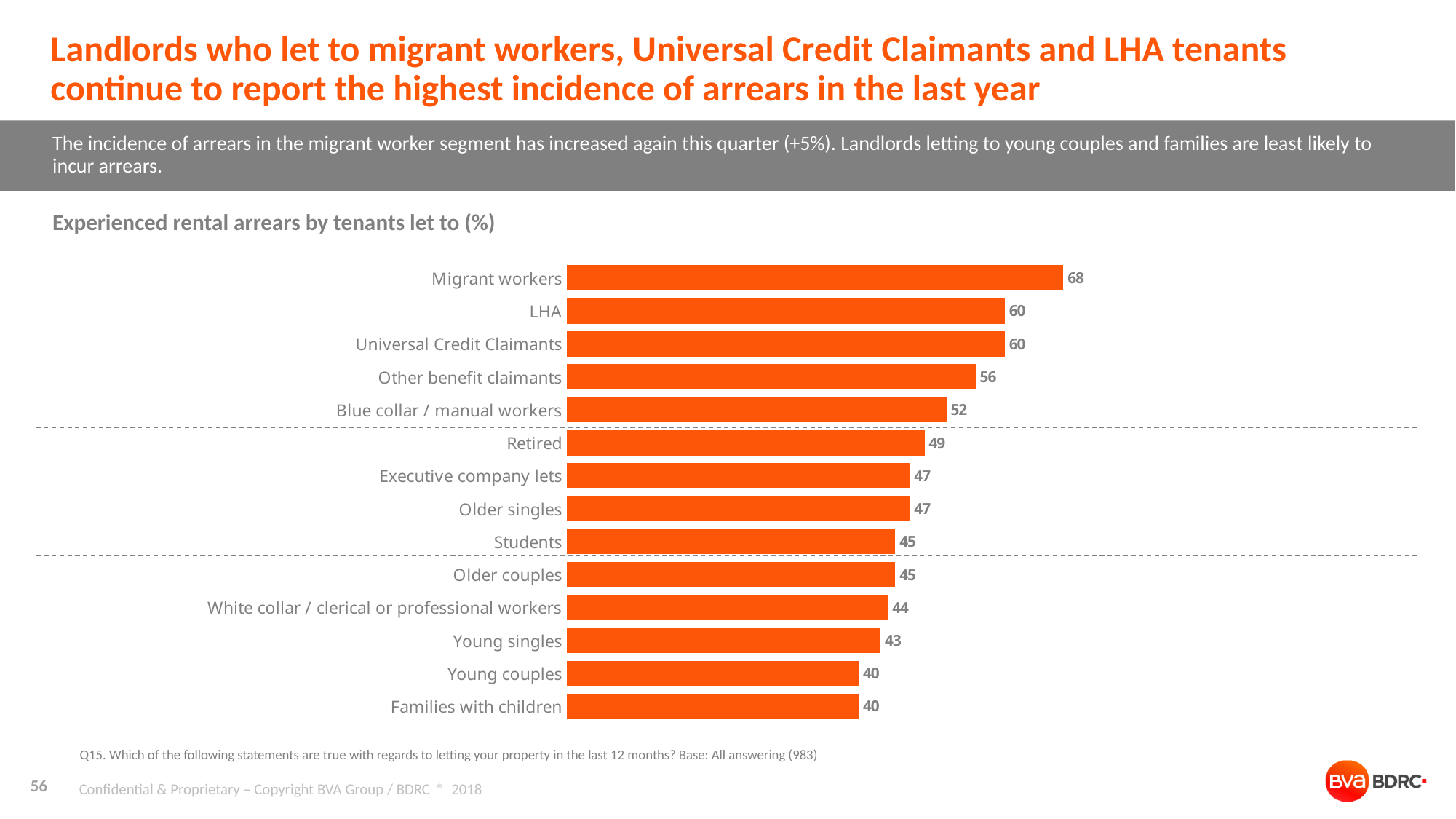
What colour are the bars in the chart? Orange What is the title of the chart? Experienced rental arrears by tenants let to (%) Which is larger, the value for LHA or the value for Other benefit claimants? LHA What kind of chart is shown on the slide? Bar chart Which is larger, the value for Students or the value for Young couples? Students Which category has the highest value? Migrant workers What is the value for Retired? 49 What is the value for Young singles? 43 What is the difference between the values for Migrant workers and Families with children? 28 How many categories are shown in the chart? 14 What is the value for Migrant workers? 68 What is the difference between the values for Other benefit claimants and Blue collar / manual workers? 4